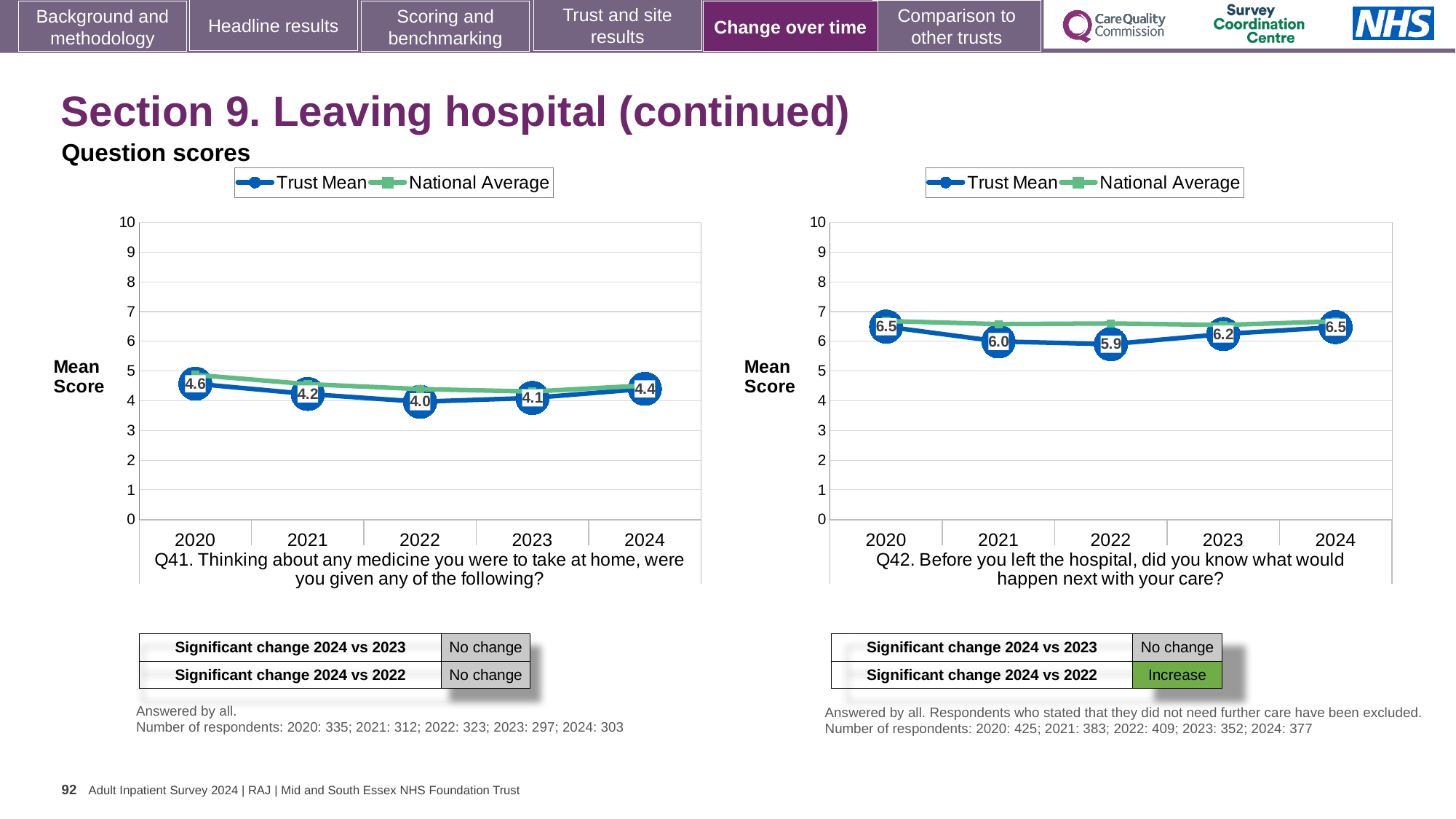
In the Q42 chart on the right, what is the difference between the Trust Mean scores for 2024 and 2022? 0.6 In the Q41 chart on the left, what is the difference between the Trust Mean scores for 2020 and 2022? 0.6 In the Q42 chart on the right, is the National Average for 2020 greater or less than 6? greater In the Q41 chart on the left, what is the Trust Mean score for 2022? 4.0 In the Q41 chart on the left, what is the Trust Mean score for 2024? 4.4 In the Q42 chart on the right, is the Trust Mean score for 2023 higher or lower than for 2021? higher How many series does the legend of the Q42 chart on the right list? 2 In the Q41 chart on the left, which year has the lowest Trust Mean score? 2022 In the Q42 chart on the right, which year has the lowest Trust Mean score? 2022 In the Q42 chart on the right, what is the Trust Mean score for 2021? 6.0 In the Q41 chart on the left, which year has the highest Trust Mean score? 2020 How many years are plotted on the x axis of the Q41 chart on the left? 5